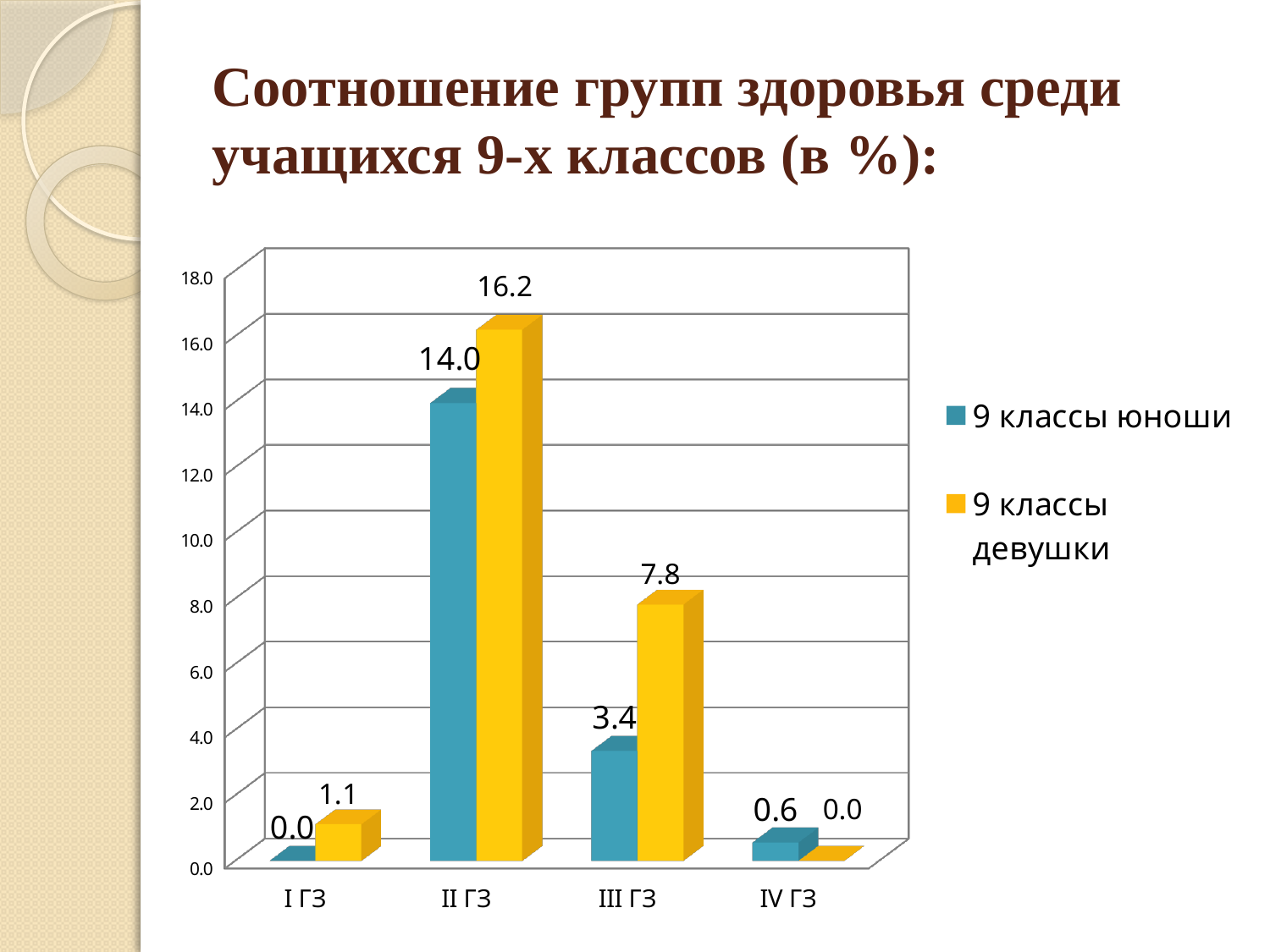
Which is larger in the III ГЗ category: 9 классы юноши or 9 классы девушки? 9 классы девушки What is the difference between the 9 классы девушки and 9 классы юноши values in the II ГЗ category? 2.2 How many categories are shown on the x axis? 4 What is the value for 9 классы юноши in the II ГЗ category? 14.0 What kind of chart is shown on the slide? Bar chart What is the value for 9 классы юноши in the IV ГЗ category? 0.6 How many series does the legend list? 2 Which category has the highest value for 9 классы девушки? II ГЗ Which category has the lowest value for 9 классы юноши? I ГЗ What is the value for 9 классы девушки in the III ГЗ category? 7.8 What colour represents the 9 классы девушки series? Yellow What is the value for 9 классы девушки in the I ГЗ category? 1.1